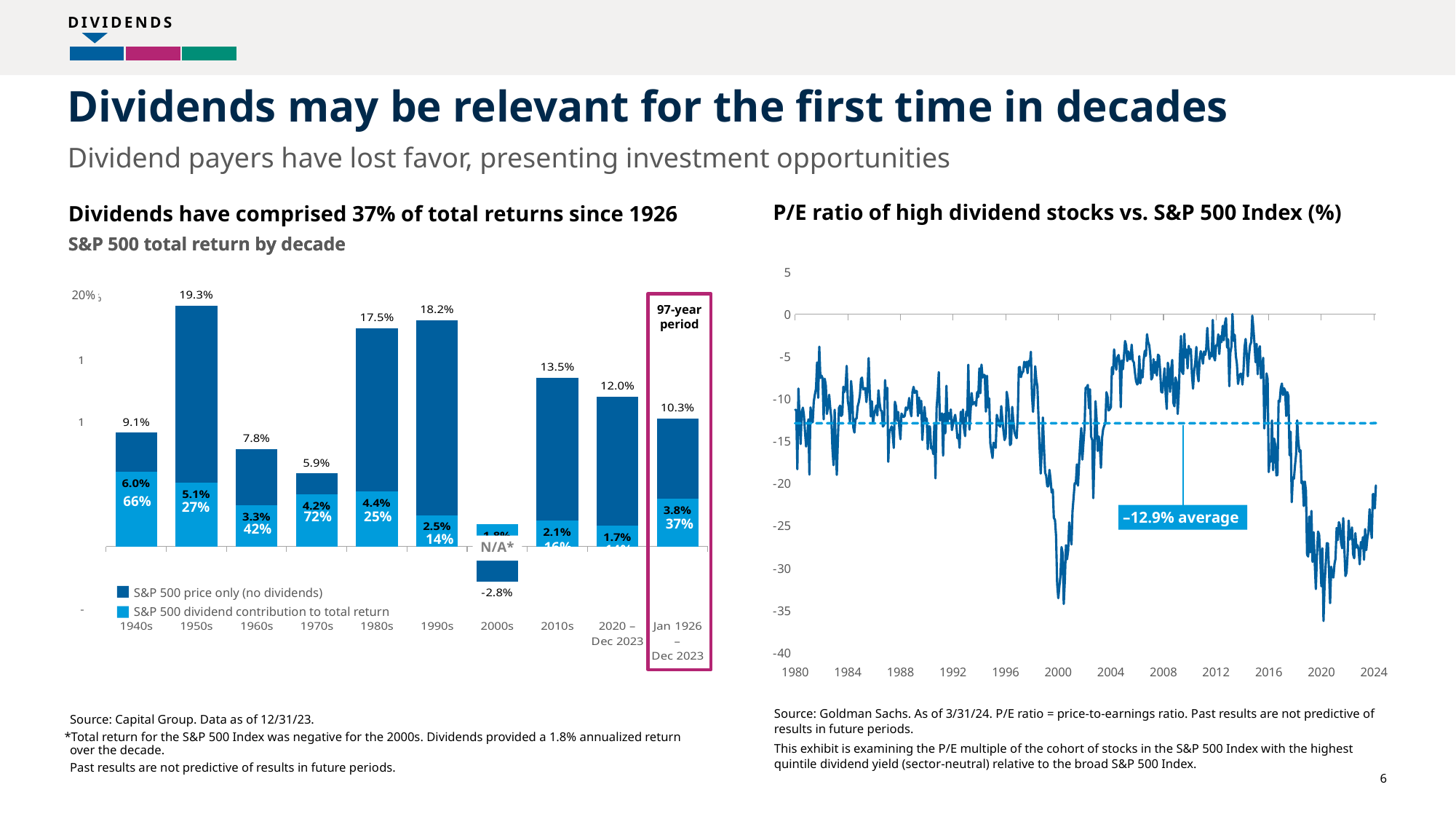
In the 'S&P 500 total return by decade' chart, which has the larger total return: the 2010s or 2020 – Dec 2023? 2010s In the 'S&P 500 total return by decade' chart, which decade has the highest total return? 1950s In the 'S&P 500 total return by decade' chart, what is the total return for the 1980s? 17.5% In the 'S&P 500 total return by decade' chart, what is the difference between the total return for the 1990s and the 1980s? 0.7% In the 'S&P 500 total return by decade' chart, what is the dividend contribution for the Jan 1926 – Dec 2023 period? 3.8% How many series does the legend of the 'S&P 500 total return by decade' chart list? 2 In the 'S&P 500 total return by decade' chart, what is the S&P 500 dividend contribution to total return for the 1970s? 4.2% In the 'P/E ratio of high dividend stocks vs. S&P 500 Index (%)' chart, what average value is marked by the dashed line? –12.9% In the 'S&P 500 total return by decade' chart, which decade has the lowest total return? 2000s What kind of chart is the 'S&P 500 total return by decade' chart on the left? bar chart How many bars (periods) are shown in the 'S&P 500 total return by decade' chart? 10 In the 'S&P 500 total return by decade' chart, what percentage of the 1940s total return came from dividends? 66%